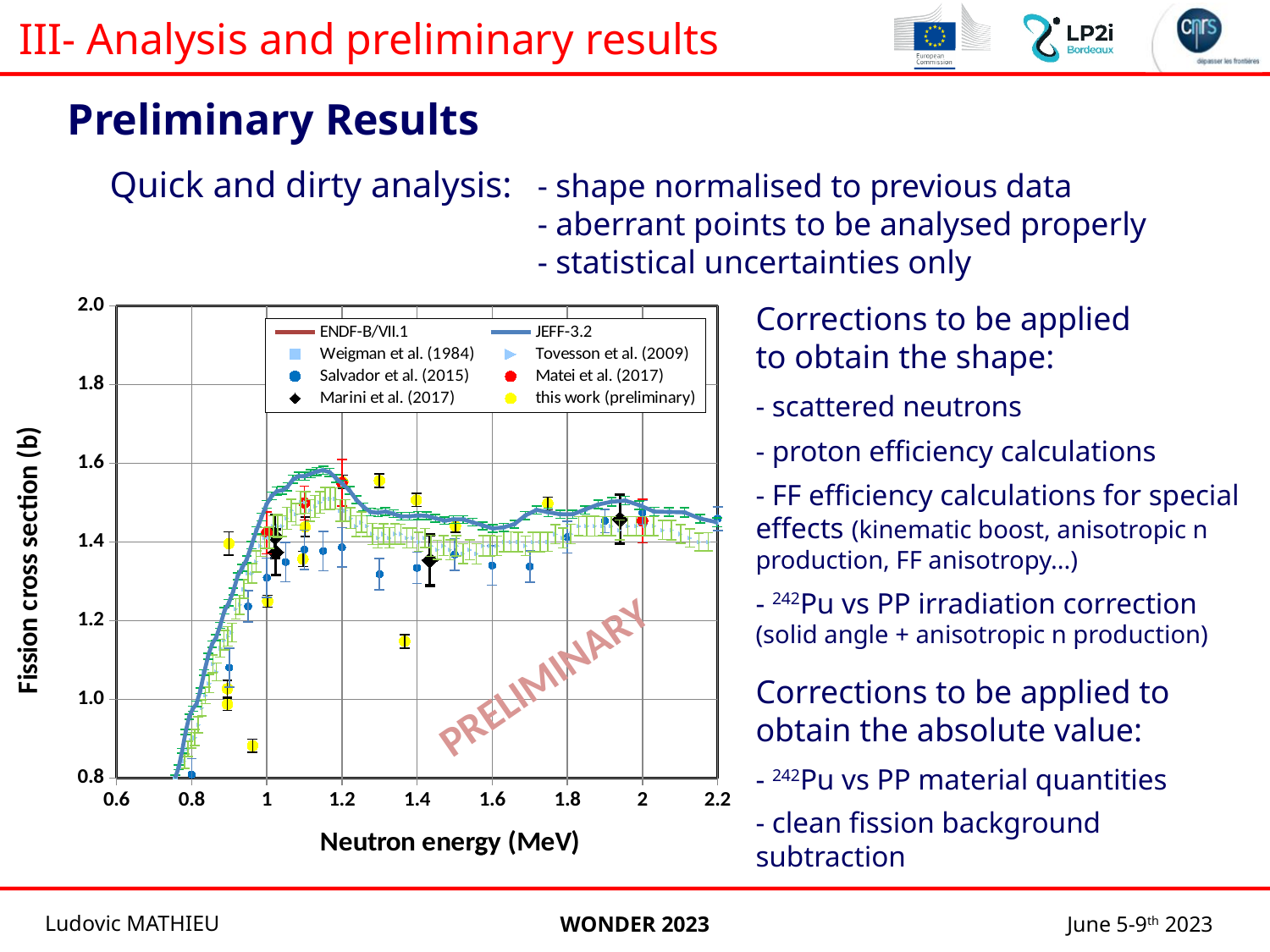
Which legend entry corresponds to the yellow markers in the chart? this work (preliminary) What is the label of the y axis of the chart? Fission cross section (b) What kind of chart is shown on the slide? Line and scatter chart Is the 'this work (preliminary)' value at about 0.95 MeV greater or less than 1.0 b? less What is the highest value shown on the y axis of the chart? 2.0 Is the 'this work (preliminary)' value at about 1.37 MeV greater or less than 1.2 b? less What is the label of the x axis of the chart? Neutron energy (MeV) Is the JEFF-3.2 curve at 2.0 MeV greater or less than 1.4 b? greater How many entries does the chart legend list? 8 Between 0.8 MeV and 1.1 MeV, does the JEFF-3.2 curve rise or fall? rise